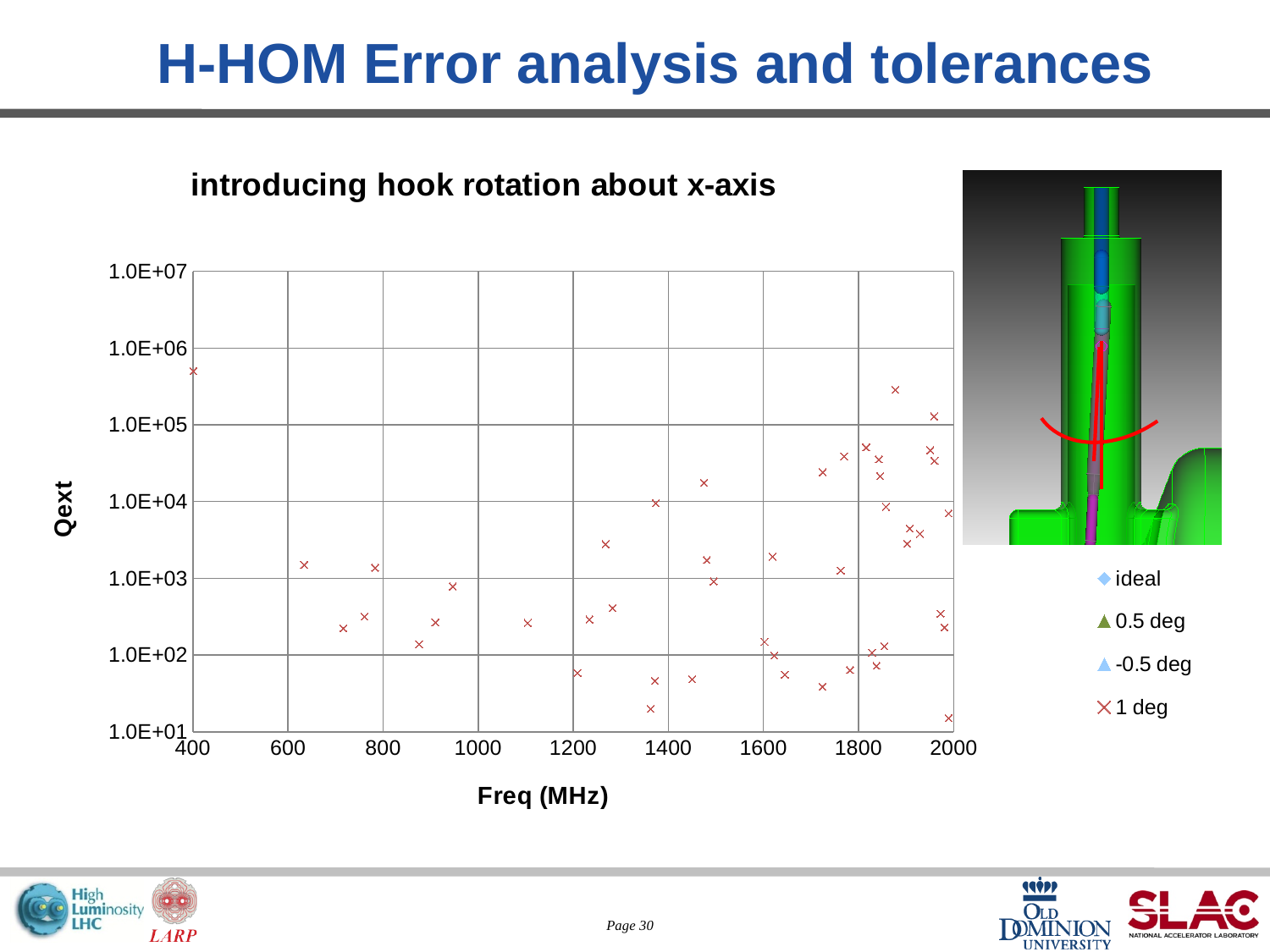
Is the point plotted near 1470 MHz with the highest Qext greater or less than 1.0E+04? greater Is the point plotted near 880 MHz greater or less than 1.0E+03 in Qext? less Is the point plotted near 630 MHz greater or less than 1.0E+03 in Qext? greater Which legend entry is drawn with an x-shaped marker? 1 deg What is the title of the chart? introducing hook rotation about x-axis What is the lowest value shown on the Qext axis? 1.0E+01 How many series does the chart legend list? 4 What kind of chart is shown on the slide? scatter chart What is the highest frequency shown on the x axis? 2000